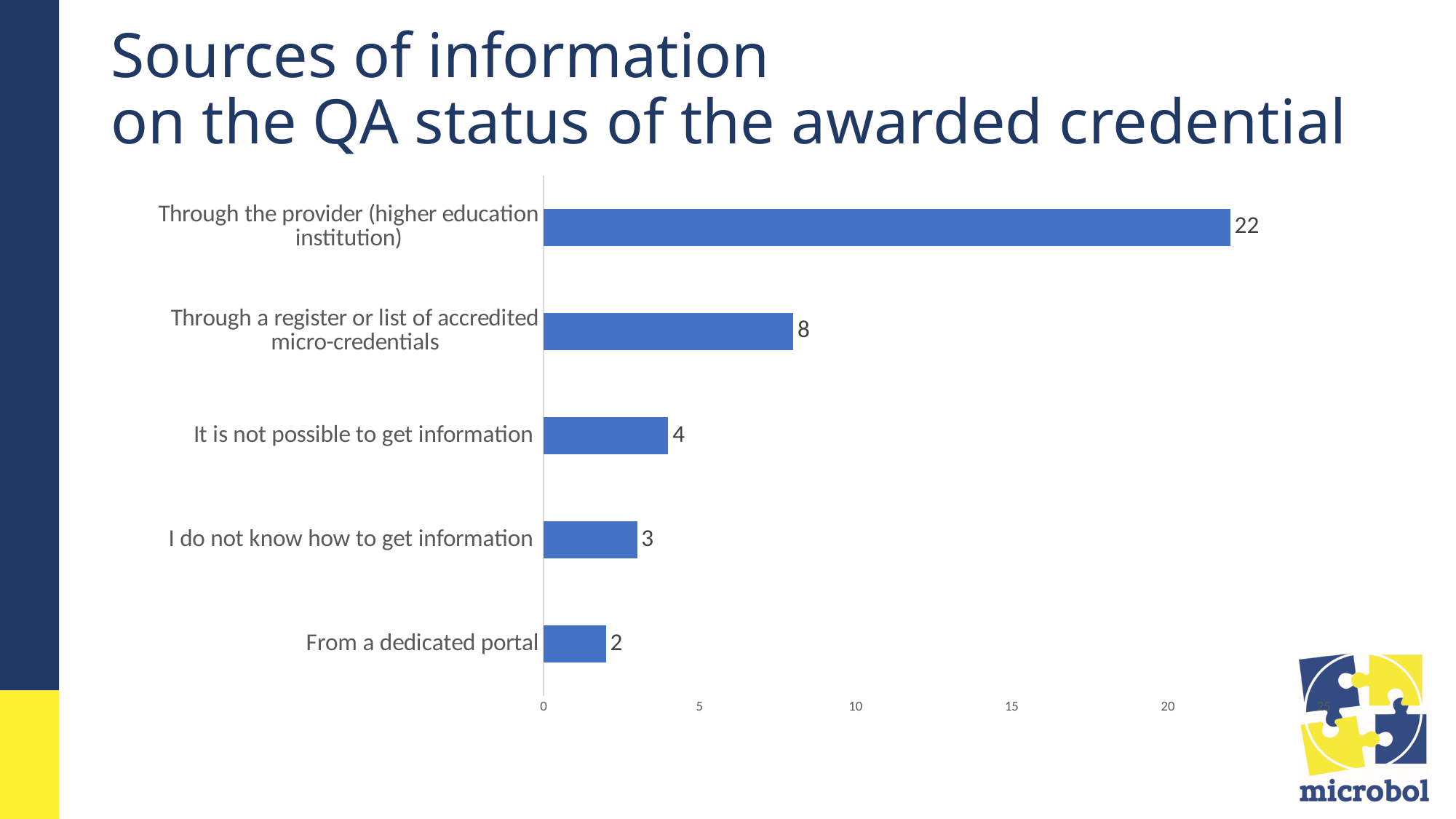
Which is larger: the value for 'It is not possible to get information' or the value for 'I do not know how to get information'? It is not possible to get information What kind of chart is shown on the slide? Bar chart Which category has the highest value? Through the provider (higher education institution) How many categories are shown in the chart? 5 Which category has the lowest value? From a dedicated portal What is the value for 'Through the provider (higher education institution)'? 22 What is the difference between the values for 'Through the provider (higher education institution)' and 'Through a register or list of accredited micro-credentials'? 14 What is the value for 'Through a register or list of accredited micro-credentials'? 8 What is the value for 'From a dedicated portal'? 2 Is the value for 'Through the provider (higher education institution)' greater or less than 20? greater What is the value for 'I do not know how to get information'? 3 What is the value for 'It is not possible to get information'? 4